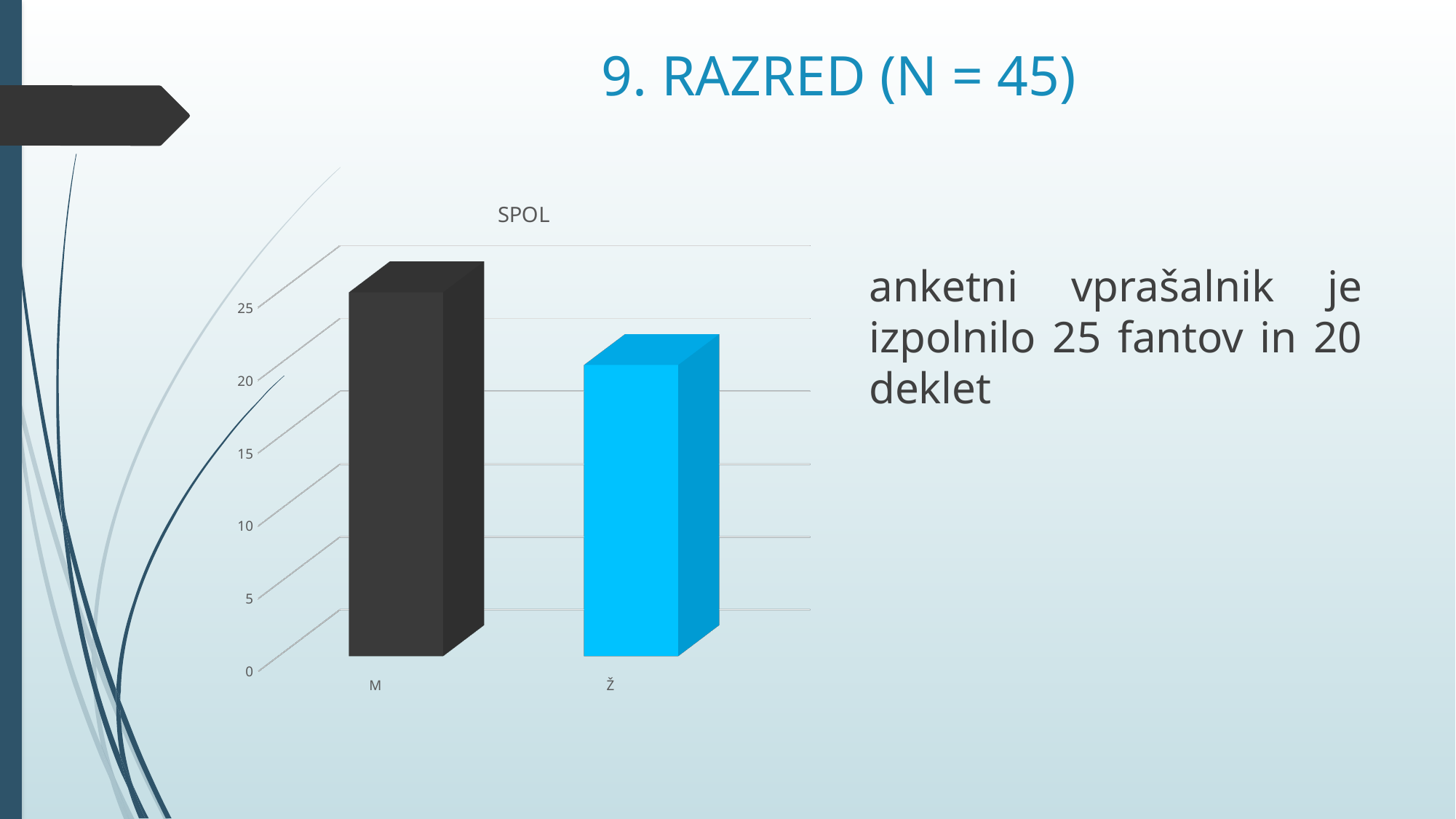
What is the value for Ž in the chart? 20 Is the value for Ž greater or less than 15? greater What is the title of the chart? SPOL Is the value for M greater or less than 20? greater How many categories are shown on the x axis of the chart? 2 Is the bar for M taller or shorter than the bar for Ž? taller Which category has the highest bar in the chart? M What kind of chart is shown on the slide? bar chart Which category has the lowest bar in the chart? Ž What colour is the bar for Ž? blue What is the difference between the values for M and Ž? 5 What is the value for M in the chart? 25